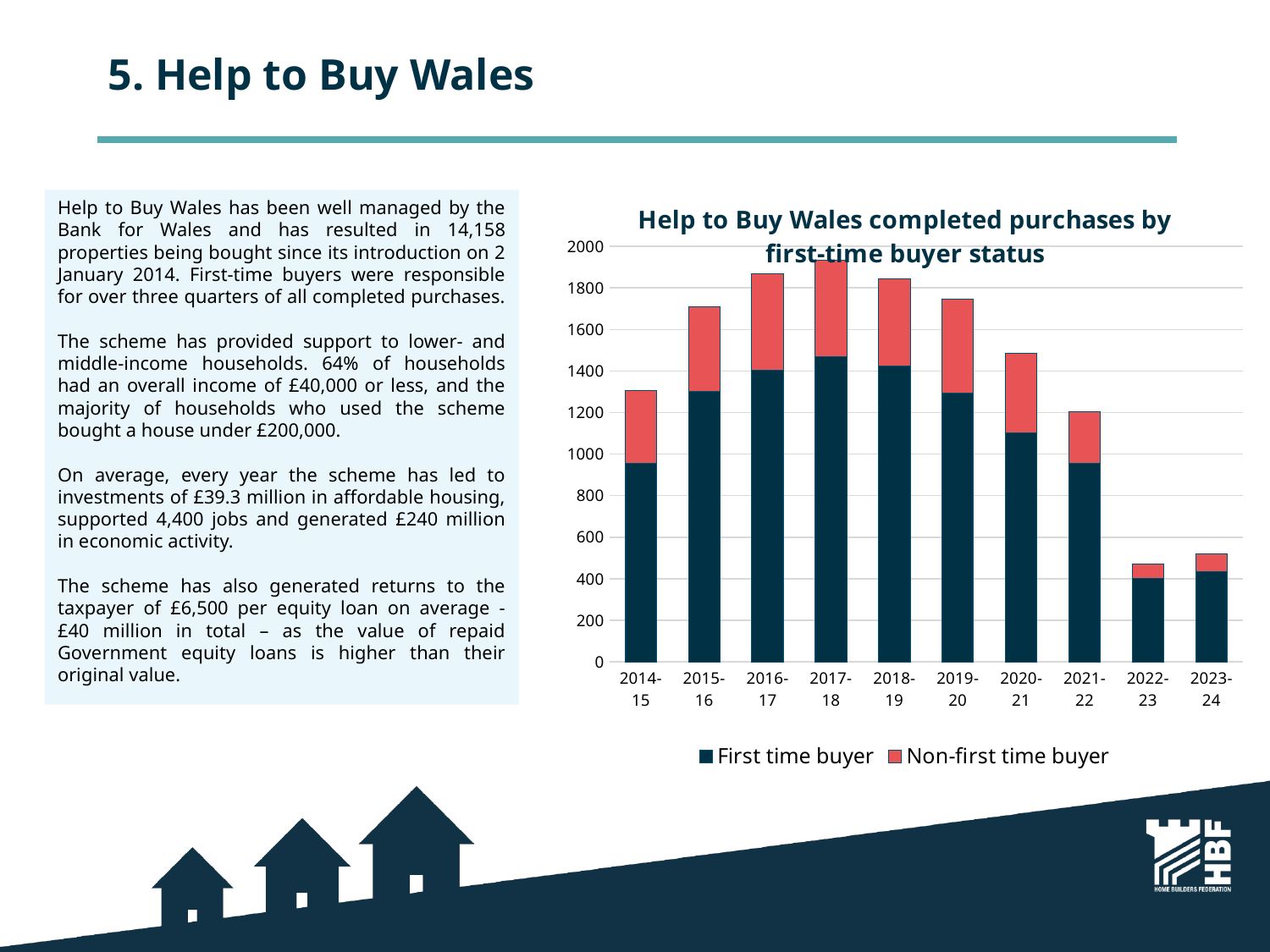
Is the total value for 2022-23 greater or less than 600? less Which year has a higher total of completed purchases, 2015-16 or 2020-21? 2015-16 How many financial years are shown on the x axis of the chart? 10 How many series does the chart legend list? 2 Is the total value for 2020-21 greater or less than 1600? less Do total completed purchases rise or fall from 2017-18 to 2022-23? fall What is the title of the chart? Help to Buy Wales completed purchases by first-time buyer status Is the total value for 2014-15 greater or less than 1200? greater Which year has the lowest total completed purchases in the chart? 2022-23 What kind of chart is shown on the slide? Stacked bar chart Which year has the highest total completed purchases in the chart? 2017-18